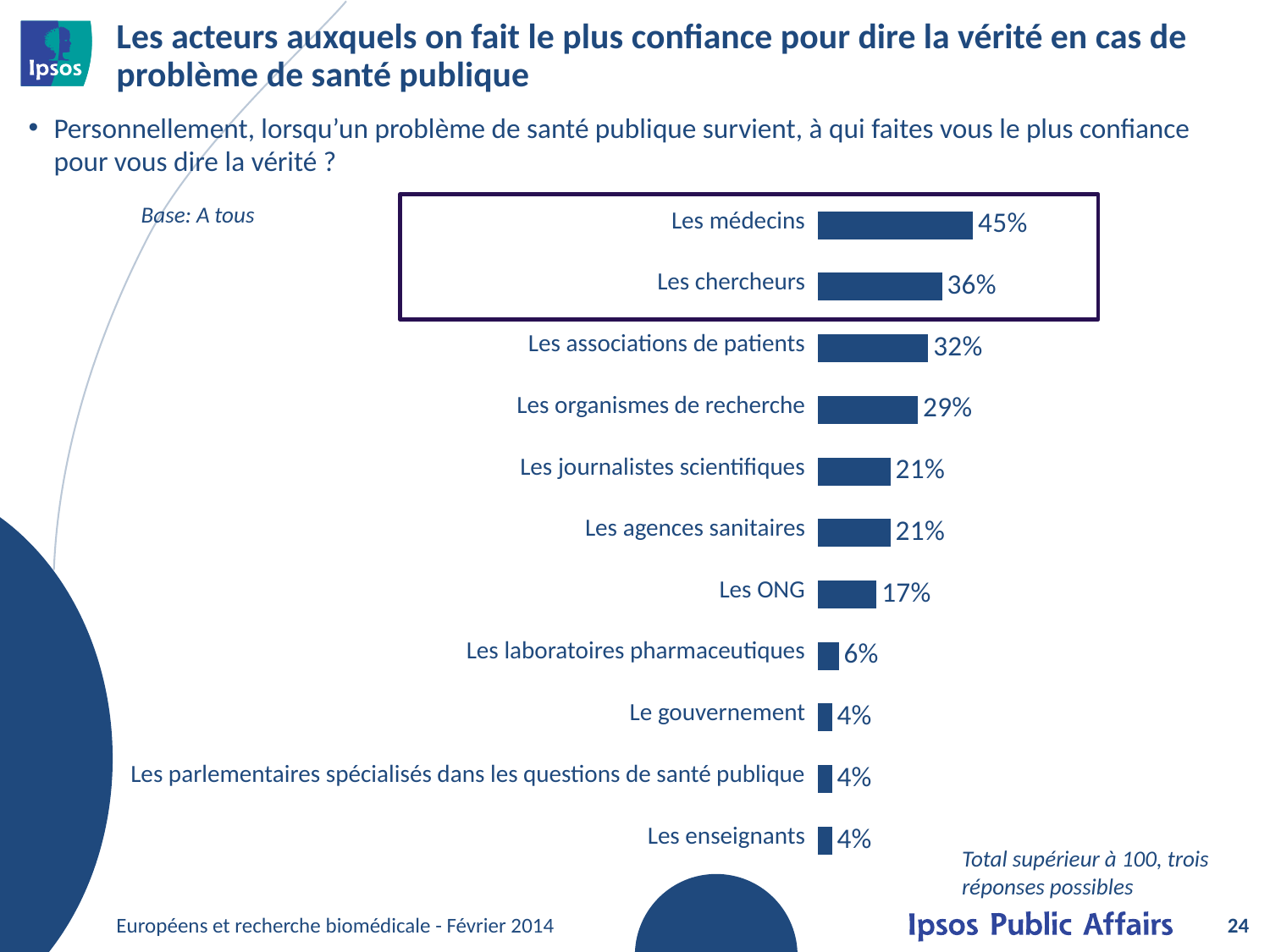
Which is larger, the value for 'Les laboratoires pharmaceutiques' or the value for 'Le gouvernement'? Les laboratoires pharmaceutiques What is the value shown for 'Les associations de patients'? 32% How many categories are shown in the chart? 11 How many categories share the lowest value of 4%? 3 Which is larger, the value for 'Les chercheurs' or the value for 'Les organismes de recherche'? Les chercheurs What is the value shown for 'Les ONG'? 17% What kind of chart is shown on the slide? Bar chart Which category has the highest value in the chart? Les médecins What percentage of respondents trust 'Les médecins' the most to tell the truth? 45% What is the value shown for 'Les laboratoires pharmaceutiques'? 6% What is the difference between the values for 'Les médecins' and 'Les chercheurs'? 9 percentage points What is the difference between the values for 'Les organismes de recherche' and 'Les ONG'? 12 percentage points